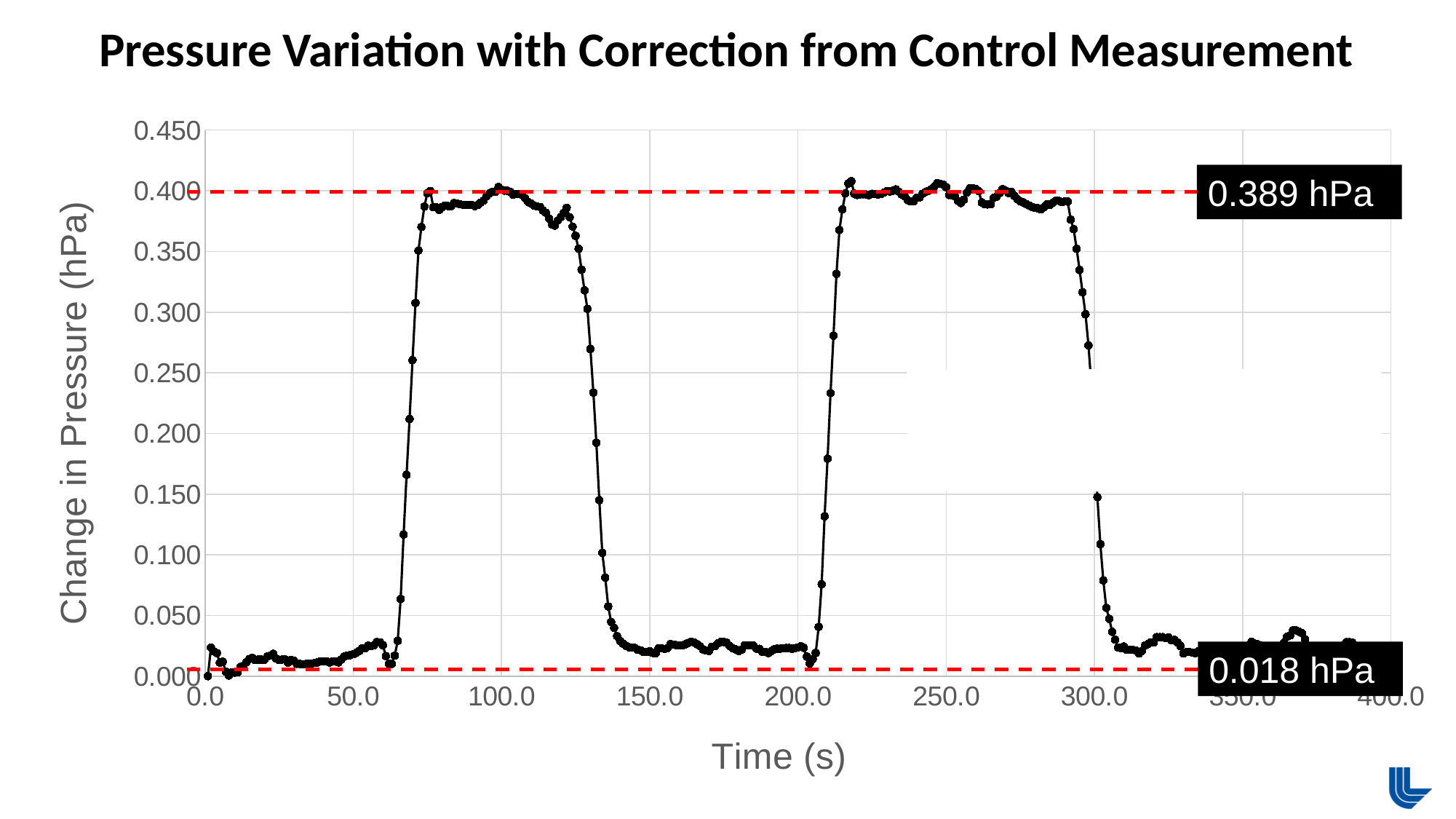
What is the difference between the upper and lower red dashed reference line values? 0.371 hPa Is the change in pressure at 250 s greater or less than 0.300 hPa? greater Which is larger, the change in pressure at 100 s or at 150 s? 100 s Is the change in pressure at 100 s greater or less than 0.350 hPa? greater What is the label of the y axis? Change in Pressure (hPa) What kind of chart is shown on the slide? line chart What value is labelled on the lower red dashed reference line? 0.018 hPa What value is labelled on the upper red dashed reference line? 0.389 hPa Between about 120 s and 140 s, does the change in pressure rise or fall? fall Is the change in pressure at 350 s greater or less than 0.100 hPa? less What is the title of the chart? Pressure Variation with Correction from Control Measurement